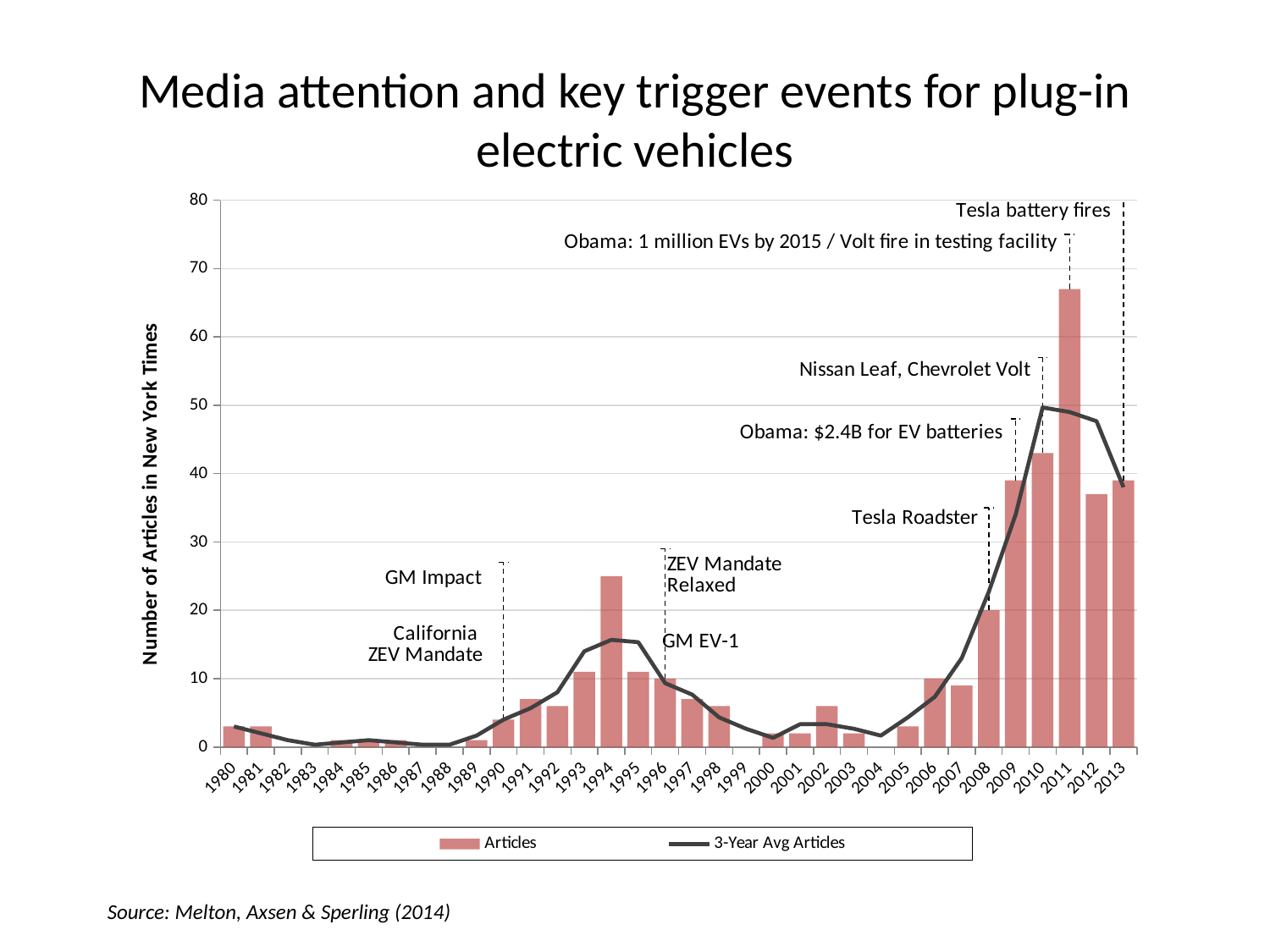
Is the value for Articles in 1994 greater or less than 20? greater Is the value for Articles in 2010 greater or less than 40? greater Is the value for Articles in 2002 greater or less than 10? less Do the number of articles rise or fall from 2005 to 2011? rise What kind of chart is shown on the slide? A bar chart with a line overlay Which year has more articles, 2010 or 2011? 2011 How many years are shown on the x axis? 34 Which year has the highest number of articles? 2011 What is the label of the y axis? Number of Articles in New York Times Which year has more articles, 1994 or 1995? 1994 How many series does the legend list? 2